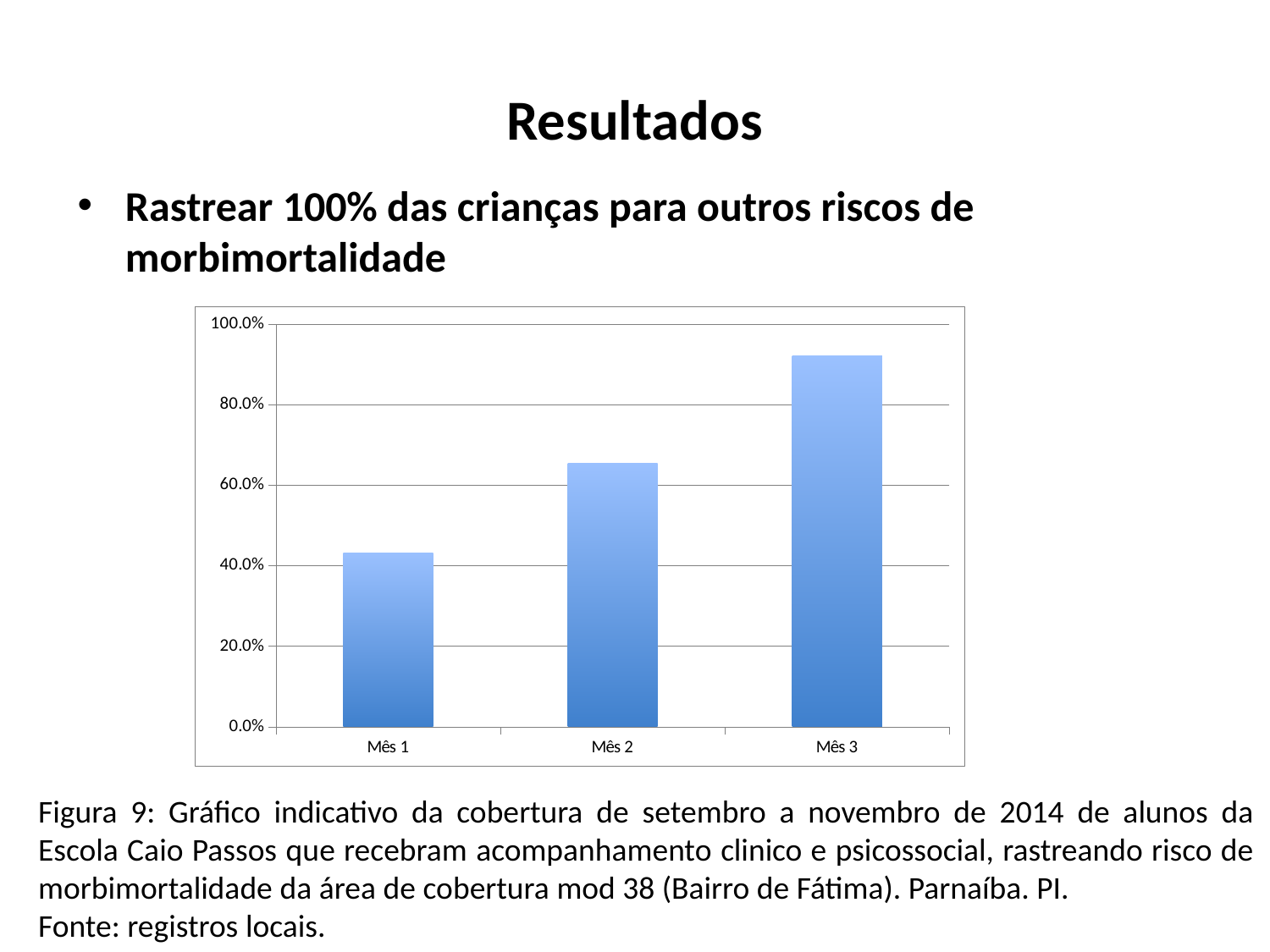
Is the value for Mês 2 greater or less than 80.0%? less How many categories are plotted on the x axis of the chart? 3 Is the value for Mês 1 greater or less than 40.0%? greater Is the value for Mês 3 greater or less than 80.0%? greater Which category has the lowest bar in the chart? Mês 1 Which category has the highest bar in the chart? Mês 3 Do the values rise or fall from Mês 1 to Mês 3? rise What kind of chart is shown on the slide? bar chart Which is larger, the value for Mês 2 or the value for Mês 3? Mês 3